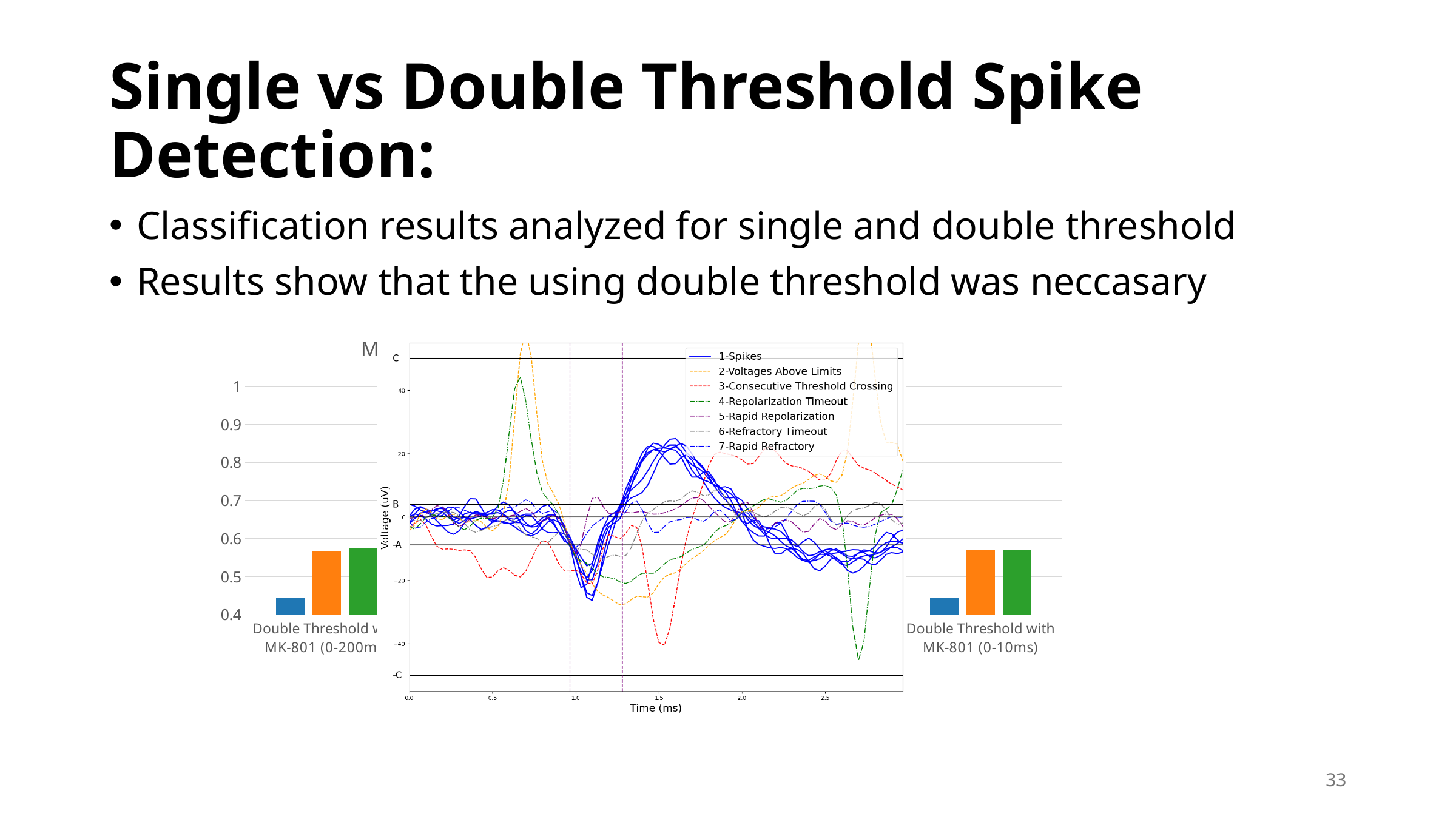
In the bar chart, for "Double Threshold with MK-801 (0-10ms)", which bar is the lowest? the blue bar What is the x-axis label of the overlaid line chart? Time (ms) In the bar chart, is the value of the blue bar for "Double Threshold with MK-801 (0-10ms)" greater or less than 0.5? less In the bar chart, what is the lowest value shown on the vertical axis? 0.4 In the bar chart, is the value of the orange bar for "Double Threshold with MK-801 (0-10ms)" greater or less than 0.5? greater How many series does the legend of the overlaid line chart (Voltage vs Time) list? 7 In the bar chart, for "Double Threshold with MK-801 (0-10ms)", which is larger: the blue bar or the orange bar? the orange bar In the overlaid line chart, which legend entry is drawn as a solid blue line? 1-Spikes In the bar chart, is the value of the green bar for "Double Threshold with MK-801 (0-10ms)" greater or less than 0.6? less What kind of chart is the chart on the left and right edges of the slide, with categories such as "Double Threshold with MK-801 (0-10ms)"? bar chart In the bar chart, how many bars are shown for the category "Double Threshold with MK-801 (0-10ms)"? 3